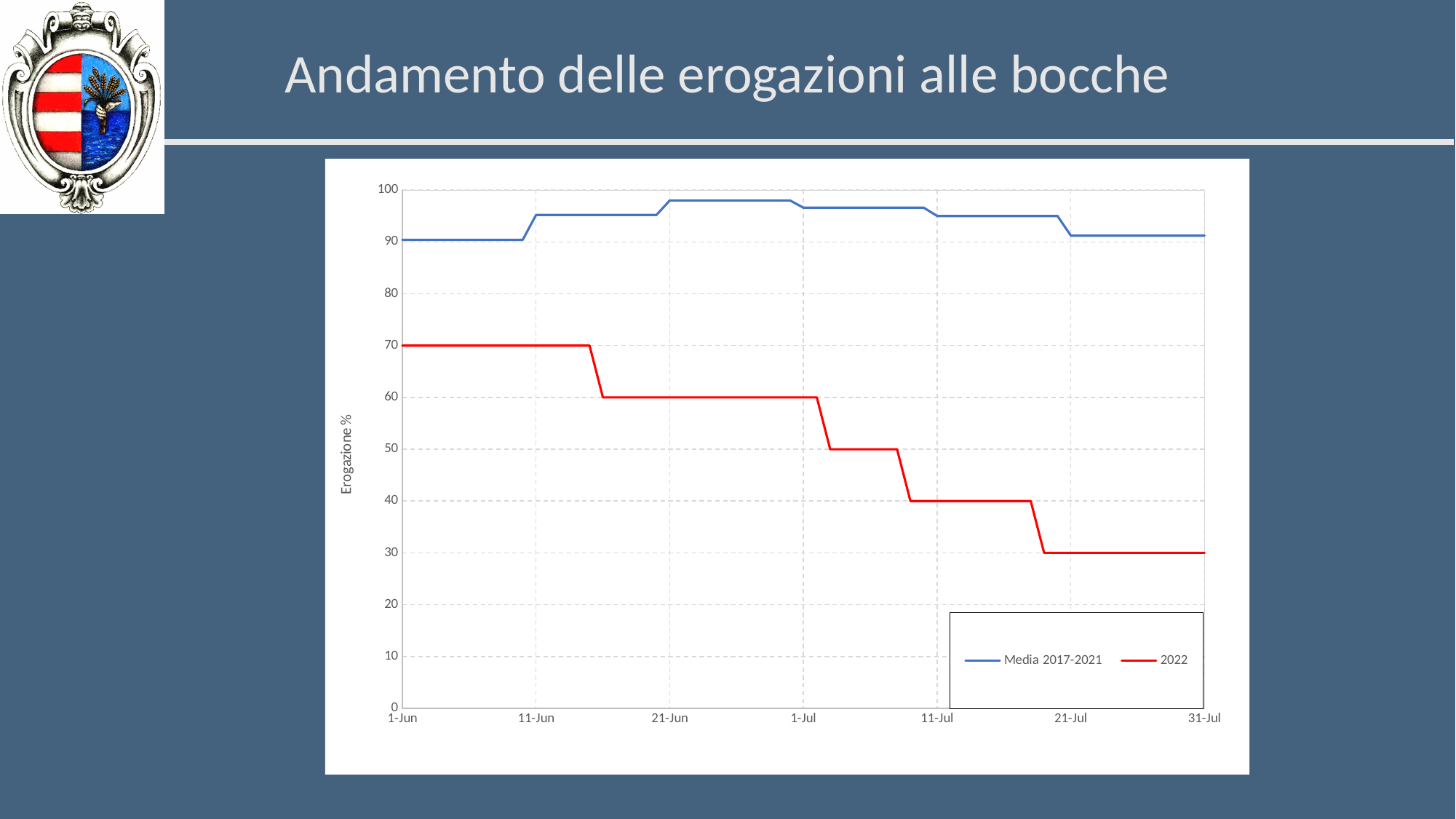
What is the value of the 2022 series on 21-Jun? 60 What is the value of the 2022 series on 31-Jul? 30 Is the value of the Media 2017-2021 series on 21-Jun greater or less than 90? greater What kind of chart is shown on the slide? line chart On 1-Jul, which series has the higher value, Media 2017-2021 or 2022? Media 2017-2021 What is the title of the vertical axis? Erogazione % Does the 2022 series rise or fall from 1-Jun to 31-Jul? fall How many series does the legend list? 2 What are the two series named in the legend? Media 2017-2021 and 2022 What is the value of the 2022 series on 1-Jun? 70 What is the value of the 2022 series on 11-Jul? 40